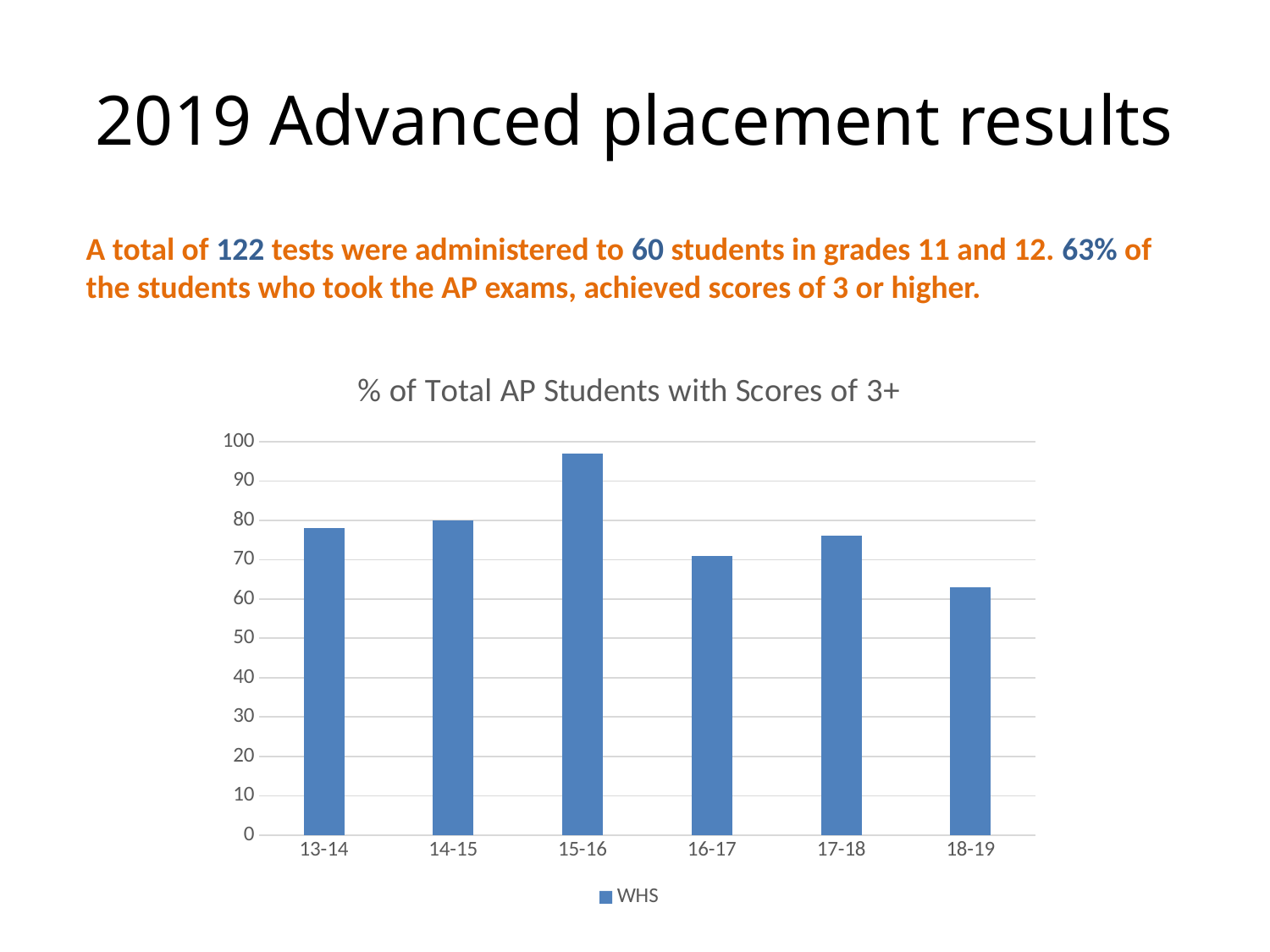
Which is larger, the value for 15-16 or the value for 16-17? 15-16 How many series does the chart legend list? 1 Which school year has the highest percentage of AP students with scores of 3+? 15-16 Which is larger, the value for 14-15 or the value for 18-19? 14-15 How many school years are shown on the x axis of the chart? 6 What is the title of the chart? % of Total AP Students with Scores of 3+ Do the values rise or fall from 15-16 to 18-19? fall What kind of chart is shown on the slide? bar chart Is the value for 15-16 greater or less than 90? greater Is the value for 18-19 greater or less than 70? less What is the name of the series shown in the legend? WHS Which school year has the lowest percentage of AP students with scores of 3+? 18-19